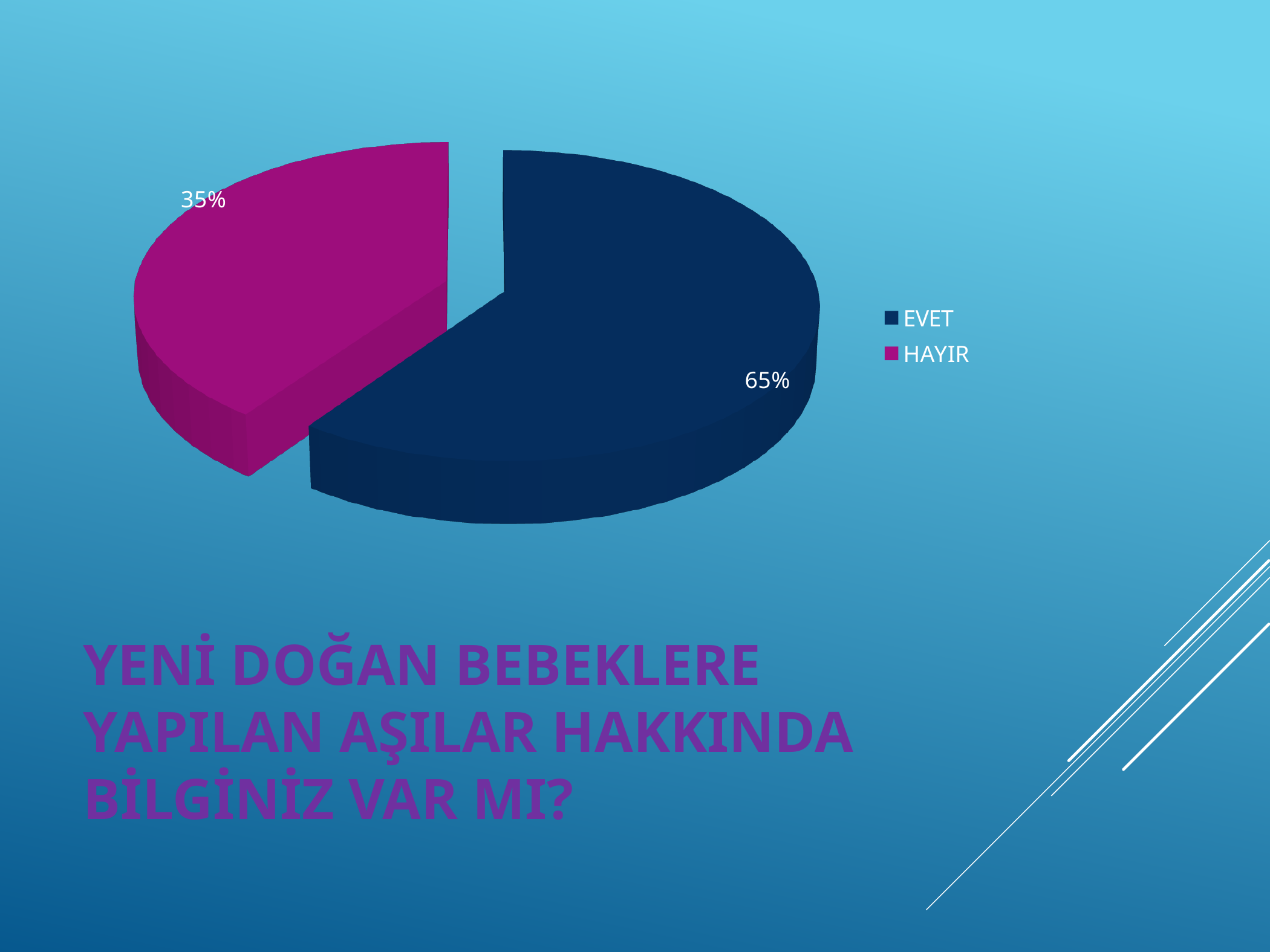
What kind of chart is shown on the slide? pie chart Which category has the smallest share of the pie? HAYIR What is the difference in percentage points between EVET and HAYIR? 30 How many entries does the legend list? 2 What percentage is shown for HAYIR? 35% What share of the pie does the HAYIR slice represent? 35% What colour is the HAYIR slice? magenta Which category has the largest share of the pie? EVET What percentage is shown for EVET? 65% How many slices does the pie chart have? 2 Which is larger, the share for EVET or the share for HAYIR? EVET What colour is the EVET slice? dark blue